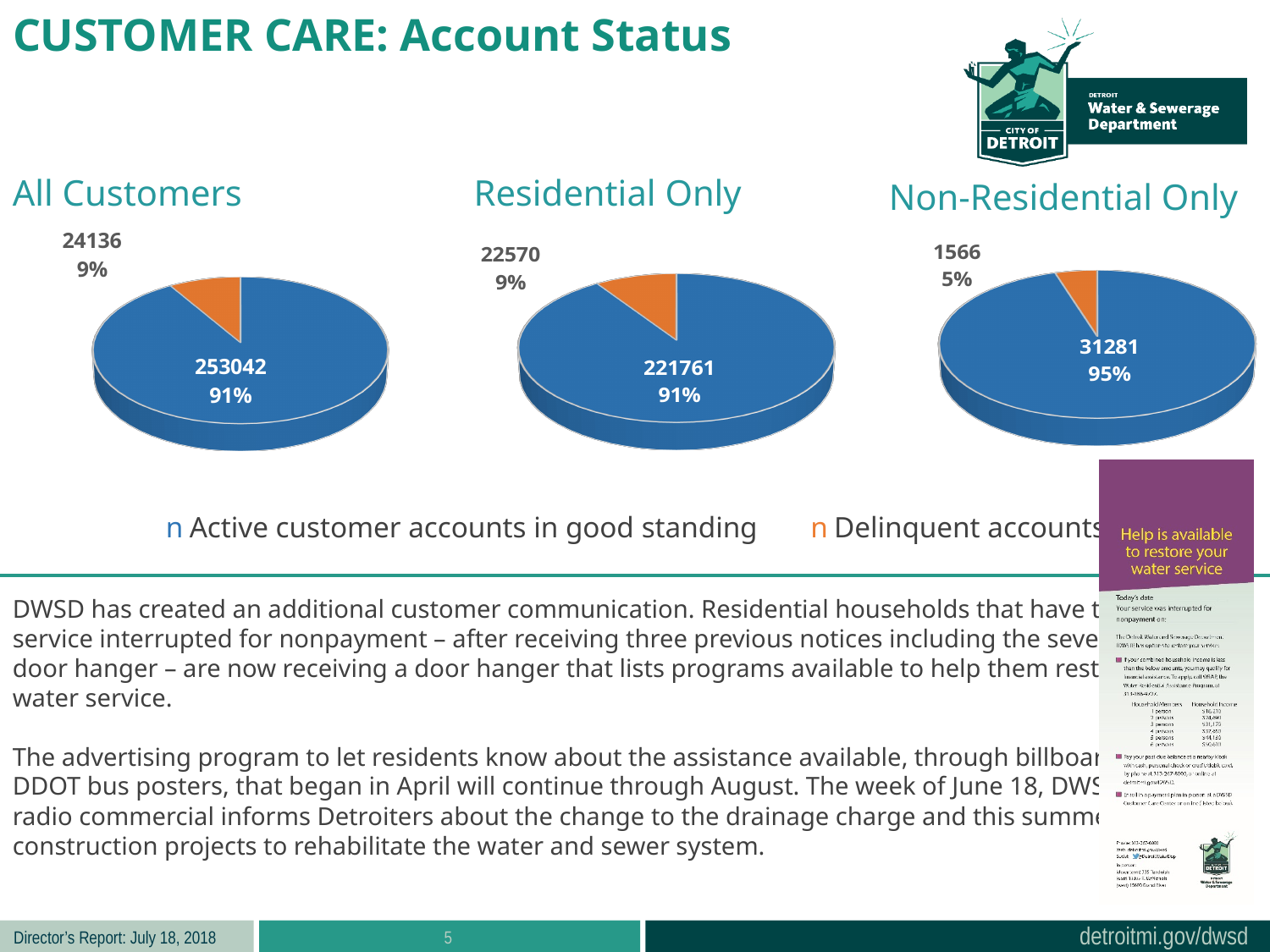
In the All Customers chart, how many active customer accounts in good standing are there? 253042 In the All Customers chart, which slice is the smallest? Delinquent accounts In the All Customers chart, what share of the pie is delinquent accounts? 9% What kind of chart is used for the All Customers chart? Pie chart In the Non-Residential Only chart, what share of the pie is delinquent accounts? 5% How many series does the legend list for the charts? 2 In the Residential Only chart, what share of the pie is active customer accounts in good standing? 91% Which chart has more delinquent accounts, Residential Only or Non-Residential Only? Residential Only In the Non-Residential Only chart, which slice is the largest? Active customer accounts in good standing In the Non-Residential Only chart, how many active customer accounts in good standing are there? 31281 In the Residential Only chart, how many delinquent accounts are there? 22570 In the All Customers chart, what is the difference between the number of active accounts in good standing and the number of delinquent accounts? 228906